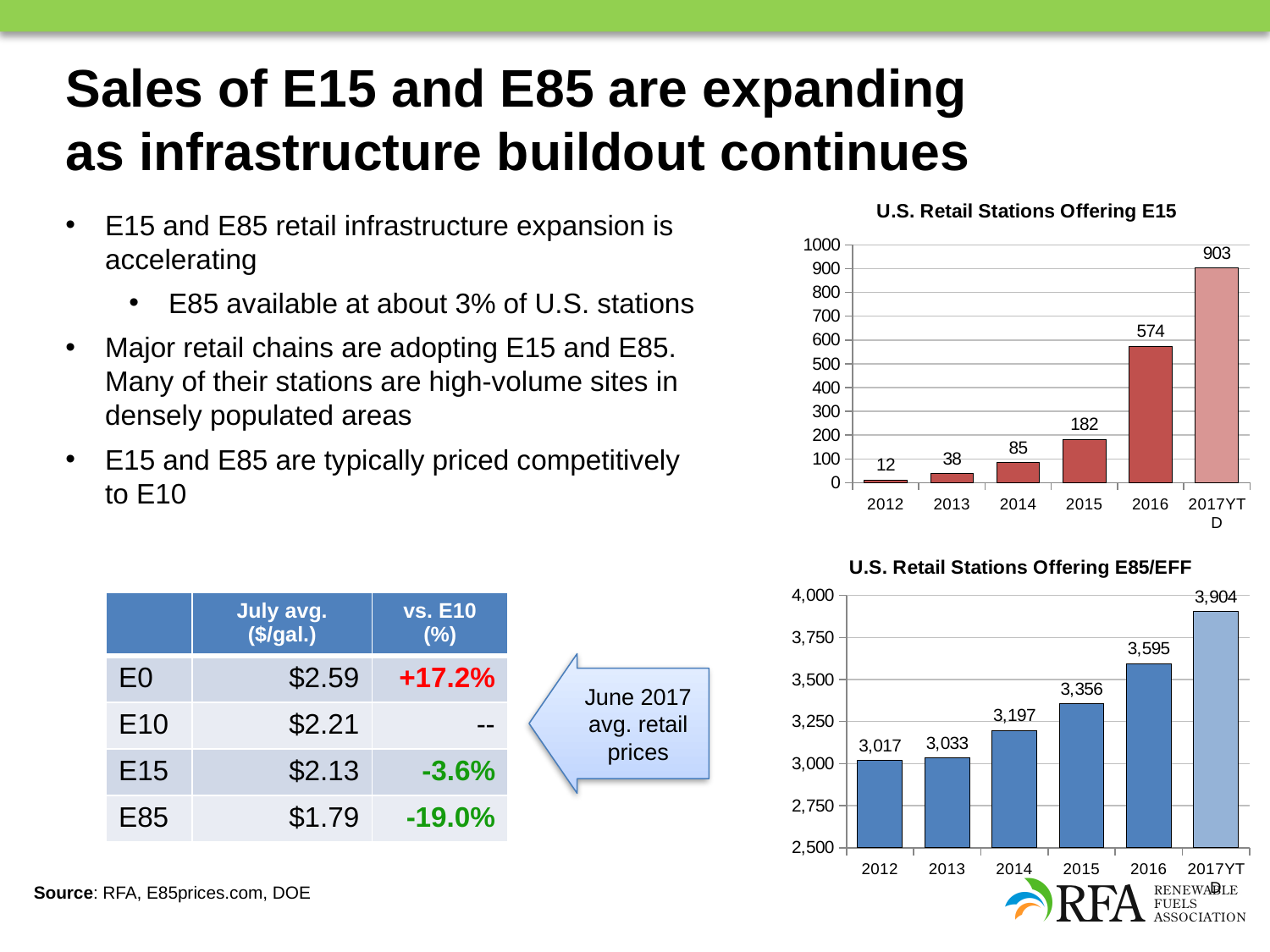
In the 'U.S. Retail Stations Offering E15' chart, do the values rise or fall from 2012 to 2017YTD? rise In the 'U.S. Retail Stations Offering E15' chart, which year has the highest value? 2017YTD In the 'U.S. Retail Stations Offering E15' chart, what is the value for 2016? 574 In the 'U.S. Retail Stations Offering E15' chart, what is the value for 2012? 12 In the 'U.S. Retail Stations Offering E85/EFF' chart, which year has the lowest value? 2012 What kind of chart is the 'U.S. Retail Stations Offering E85/EFF' chart? bar chart In the 'U.S. Retail Stations Offering E85/EFF' chart, is the value for 2015 greater or less than 3,250? greater In the 'U.S. Retail Stations Offering E85/EFF' chart, what is the difference between the 2016 and 2015 values? 239 In the 'U.S. Retail Stations Offering E85/EFF' chart, what is the value for 2014? 3,197 In the 'U.S. Retail Stations Offering E85/EFF' chart, what is the value for 2017YTD? 3,904 In the 'U.S. Retail Stations Offering E15' chart, what is the difference between the 2017YTD and 2016 values? 329 In the 'U.S. Retail Stations Offering E15' chart, how many years are shown on the x axis? 6